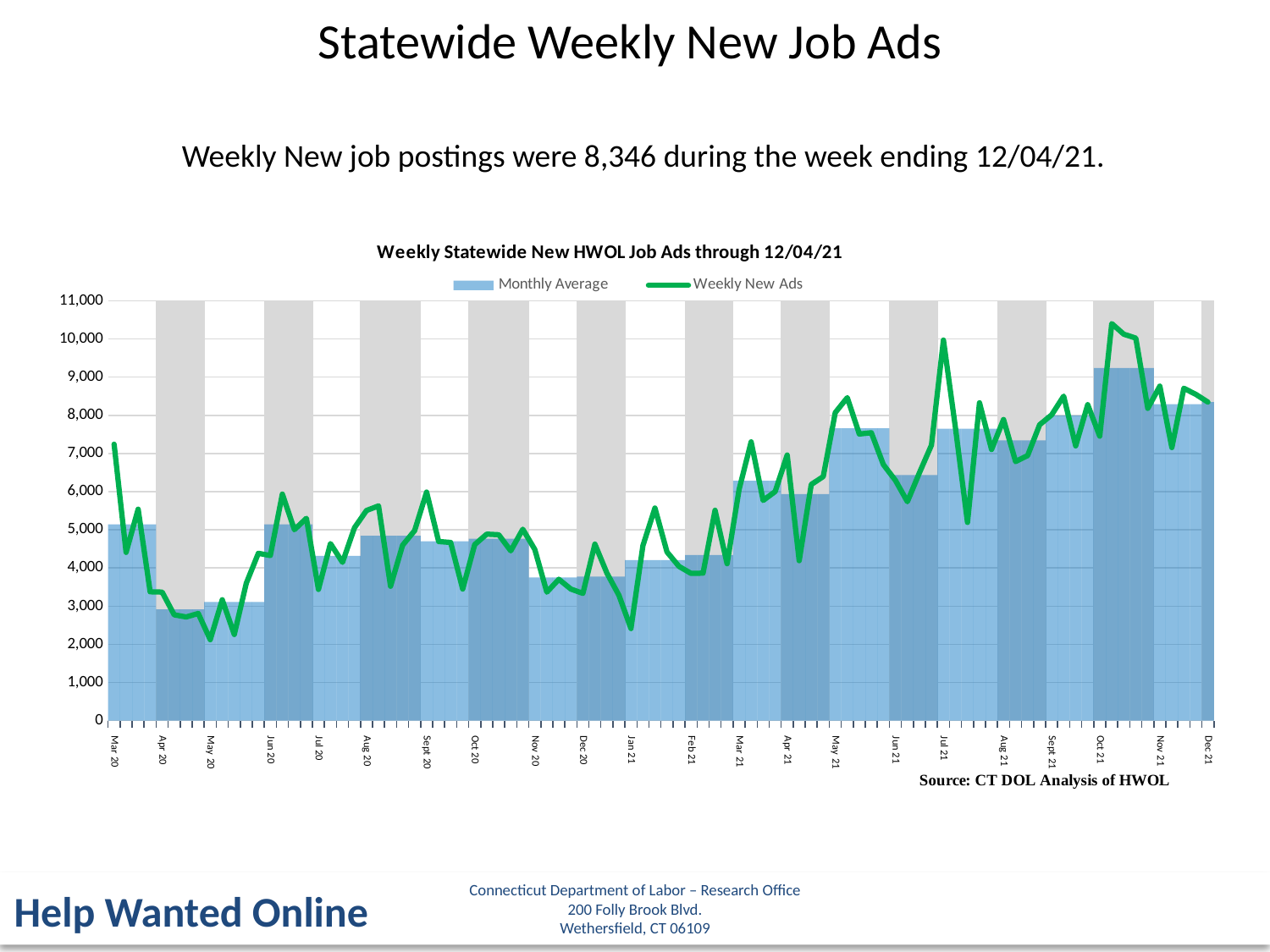
What are the two series named in the chart legend? Monthly Average and Weekly New Ads How many series does the chart legend list? 2 Is the Monthly Average value for Jul 21 greater or less than 7,000? greater Is the Monthly Average value for Nov 20 greater or less than 4,000? less According to the slide, how many weekly new job postings were there during the week ending 12/04/21? 8,346 Which month has the lowest Monthly Average bar? Apr 20 What is the title of the chart? Weekly Statewide New HWOL Job Ads through 12/04/21 Does the Monthly Average rise or fall overall from Mar 20 to Dec 21? Rises Is the Monthly Average value for Oct 21 greater or less than 9,000? greater Which has the larger Monthly Average, Feb 21 or Mar 21? Mar 21 What kind of chart is shown on the slide? A combination bar and line chart Which month has the highest Monthly Average bar? Oct 21